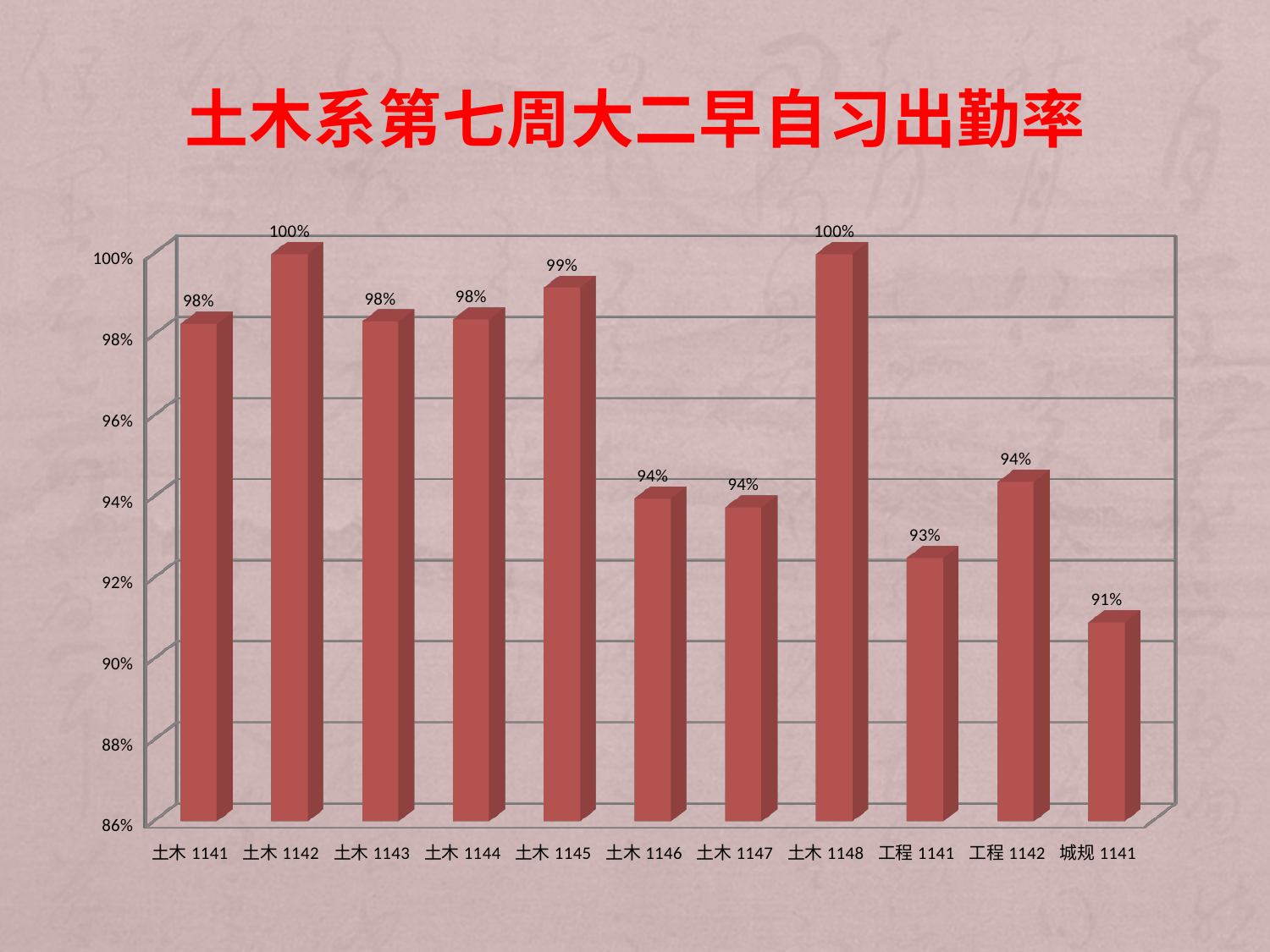
What is the attendance rate for 土木 1145? 99% What is the attendance rate for 工程 1141? 93% Which has a higher attendance rate, 土木 1141 or 工程 1142? 土木 1141 How many classes are shown on the chart? 11 What is the difference between the attendance rates of 土木 1145 and 工程 1141? 6% Which classes have the highest attendance rate of 100%? 土木 1142 and 土木 1148 Which class has the lowest attendance rate? 城规 1141 What is the difference between the attendance rates of 土木 1142 and 城规 1141? 9% What is the attendance rate for 城规 1141? 91% What is the attendance rate for 土木 1146? 94% What is the title of the chart? 土木系第七周大二早自习出勤率 What kind of chart is shown on the slide? Bar chart